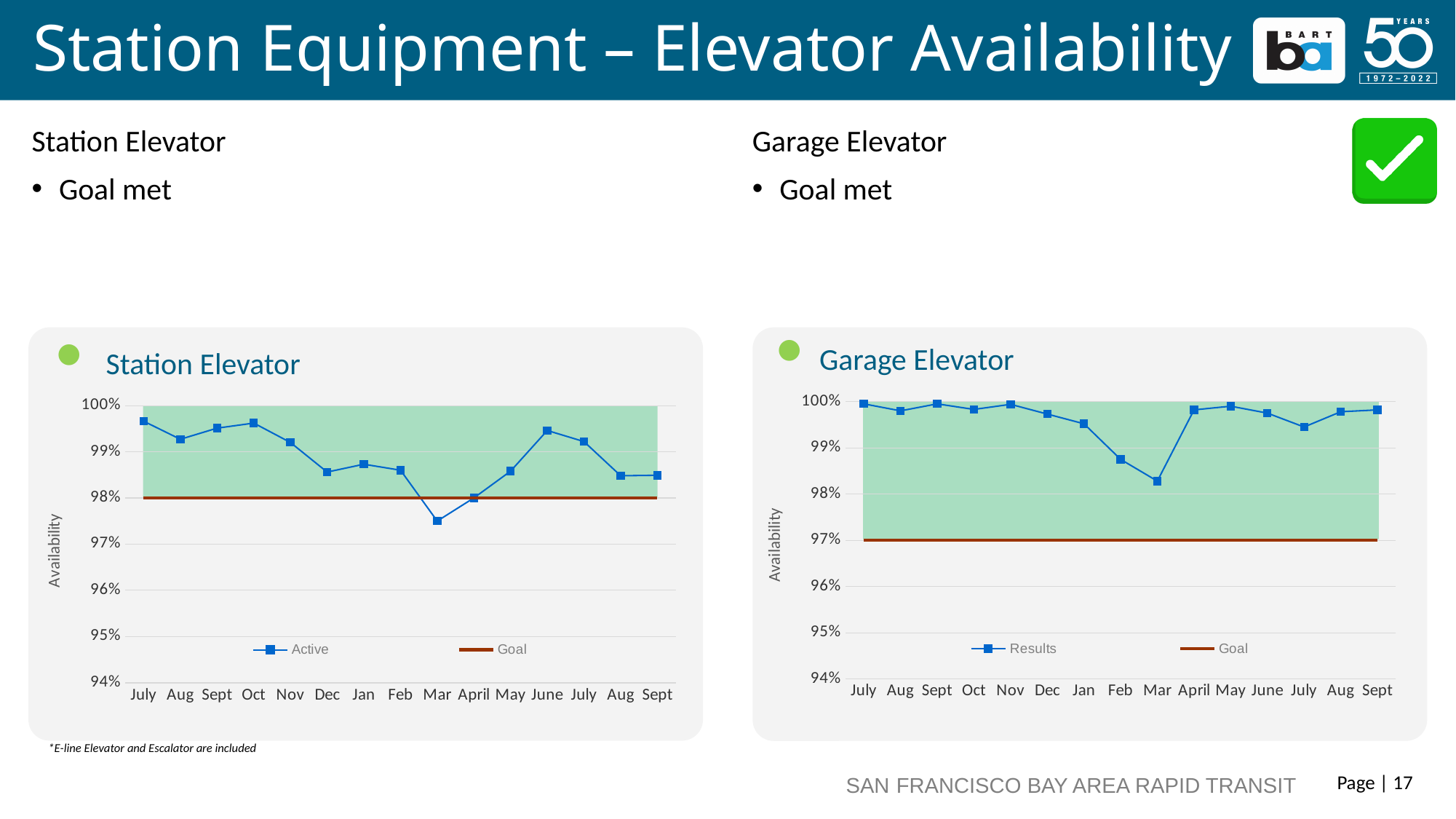
How many series does the legend of the Station Elevator chart list? 2 How many months are plotted on the x axis of the Garage Elevator chart? 15 What are the two legend entries in the Garage Elevator chart? Results and Goal In the Station Elevator chart, is the Active value for Dec greater or less than 99%? less In the Garage Elevator chart, what is the value of the Goal line? 97% In the Station Elevator chart, is the Active value for Mar greater or less than 98%? less What kind of chart is the Station Elevator chart? line chart In the Garage Elevator chart, is the Results value for Mar greater or less than 98%? greater In the Garage Elevator chart, which month has the lowest Results availability? Mar In the Station Elevator chart, what is the value of the Goal line? 98% In the Garage Elevator chart, which is larger, the Results value for Feb or for Mar? Feb In the Station Elevator chart, which month has the lowest Active availability? Mar